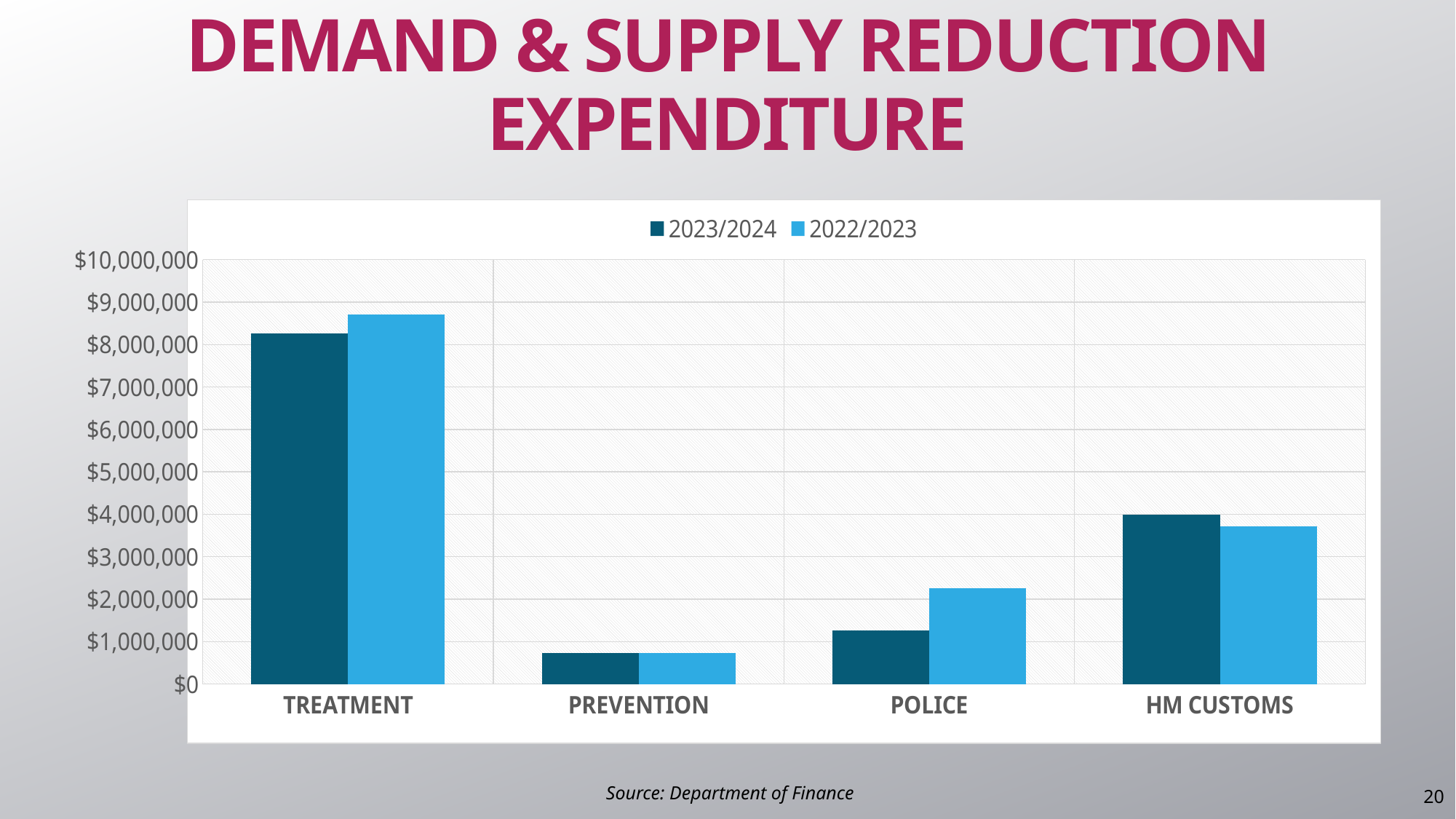
How many categories are shown on the x axis? 4 How many series does the legend list? 2 What is the source cited below the chart? Department of Finance Which category has the highest expenditure for 2023/2024? TREATMENT Is the 2022/2023 value for TREATMENT greater or less than $9,000,000? less Is the 2023/2024 value for TREATMENT greater or less than $8,000,000? greater For HM CUSTOMS, which series has the larger value, 2023/2024 or 2022/2023? 2023/2024 For POLICE, which series has the larger value, 2023/2024 or 2022/2023? 2022/2023 Which category has the lowest expenditure for 2022/2023? PREVENTION Is the 2022/2023 value for POLICE greater or less than $2,000,000? greater What kind of chart is shown on the slide? bar chart